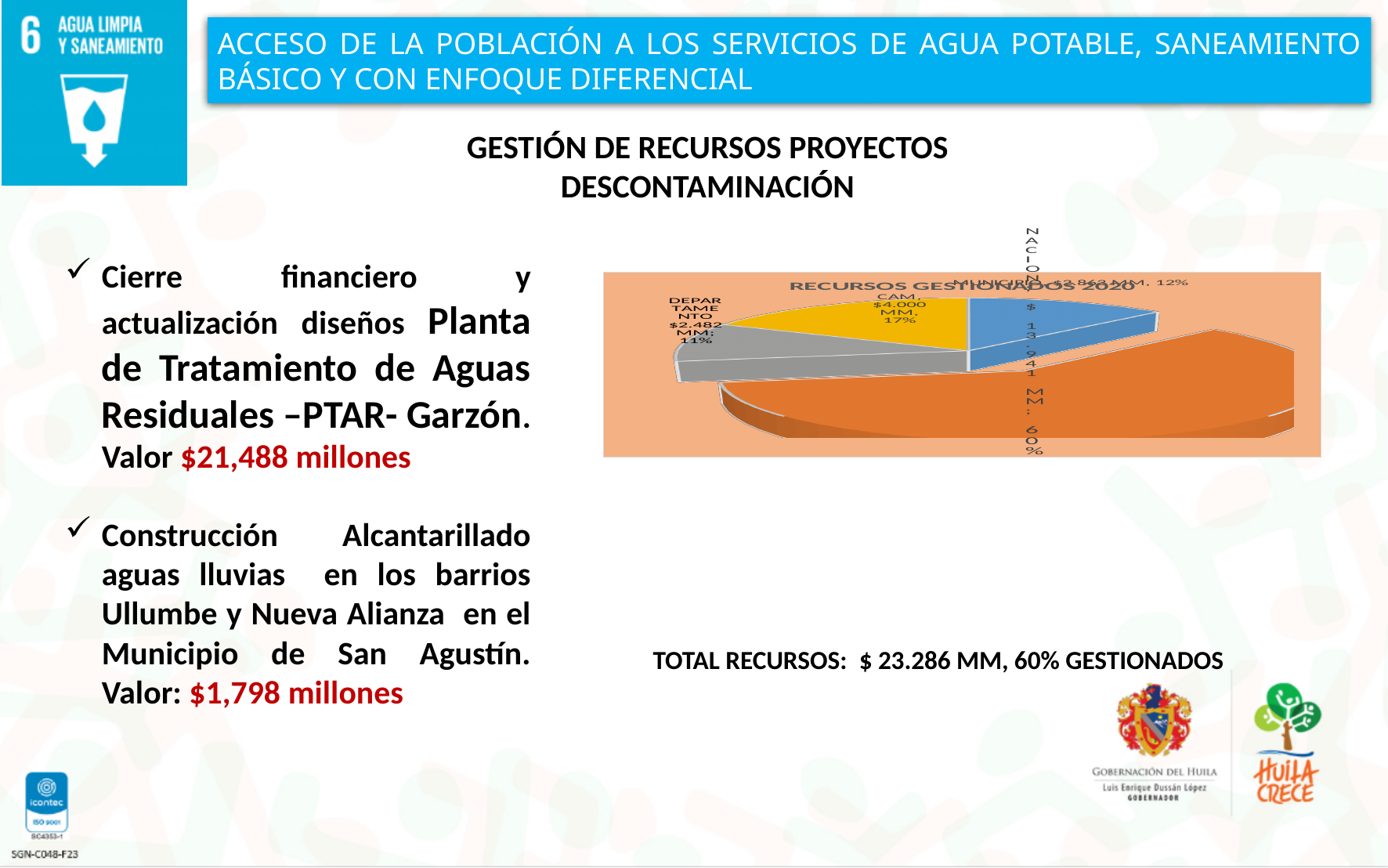
What is the value shown for CAM in the pie chart? $4.000 MM Which slice of the pie chart is the smallest? DEPARTAMENTO What share of the pie does DEPARTAMENTO represent? 11% What is the value shown for DEPARTAMENTO in the pie chart? $2.482 MM Which slice of the pie chart is the largest? NACION What share of the pie does NACION represent? 60% What share of the pie does CAM represent? 17% How many slices does the pie chart have? 4 Which is larger in the pie chart, CAM or DEPARTAMENTO? CAM What is the title of the pie chart? RECURSOS GESTIONADOS 2020 What is the value shown for NACION in the pie chart? $13.941 MM What kind of chart is shown on the slide? pie chart